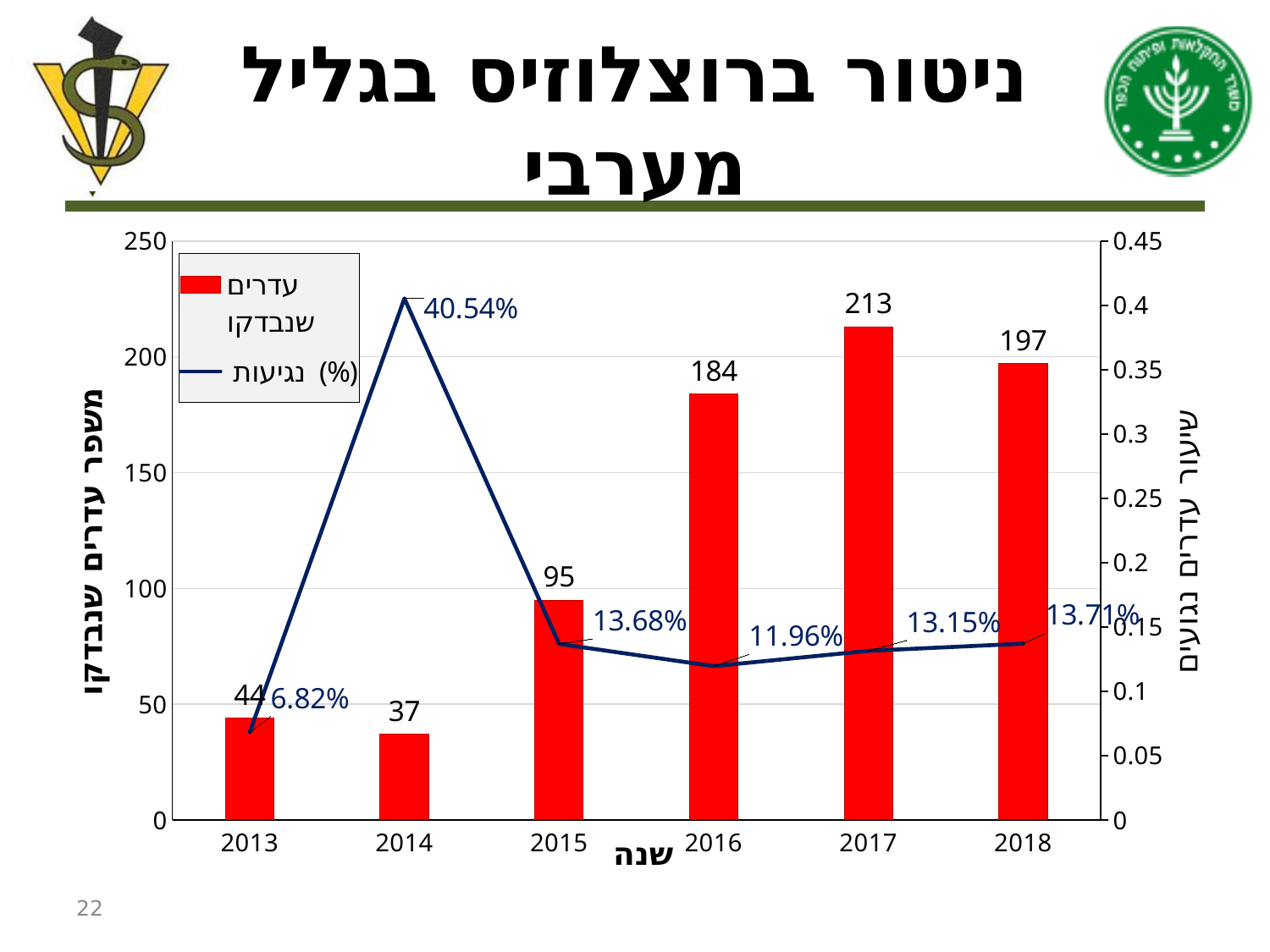
Which year has the highest number of herds tested? 2017 What is the infection rate (נגיעות) shown for 2014? 40.54% How many herds were tested (עדרים שנבדקו) in 2017? 213 What is the label of the x axis? שנה Which year has the lowest number of herds tested? 2014 Which year has the lowest infection rate (נגיעות)? 2013 How many years are shown on the x axis? 6 What kind of chart is this? Combined bar and line chart How many herds were tested in 2013? 44 Which year had more herds tested, 2015 or 2016? 2016 What is the difference in herds tested between 2017 and 2018? 16 How many series does the legend list? 2